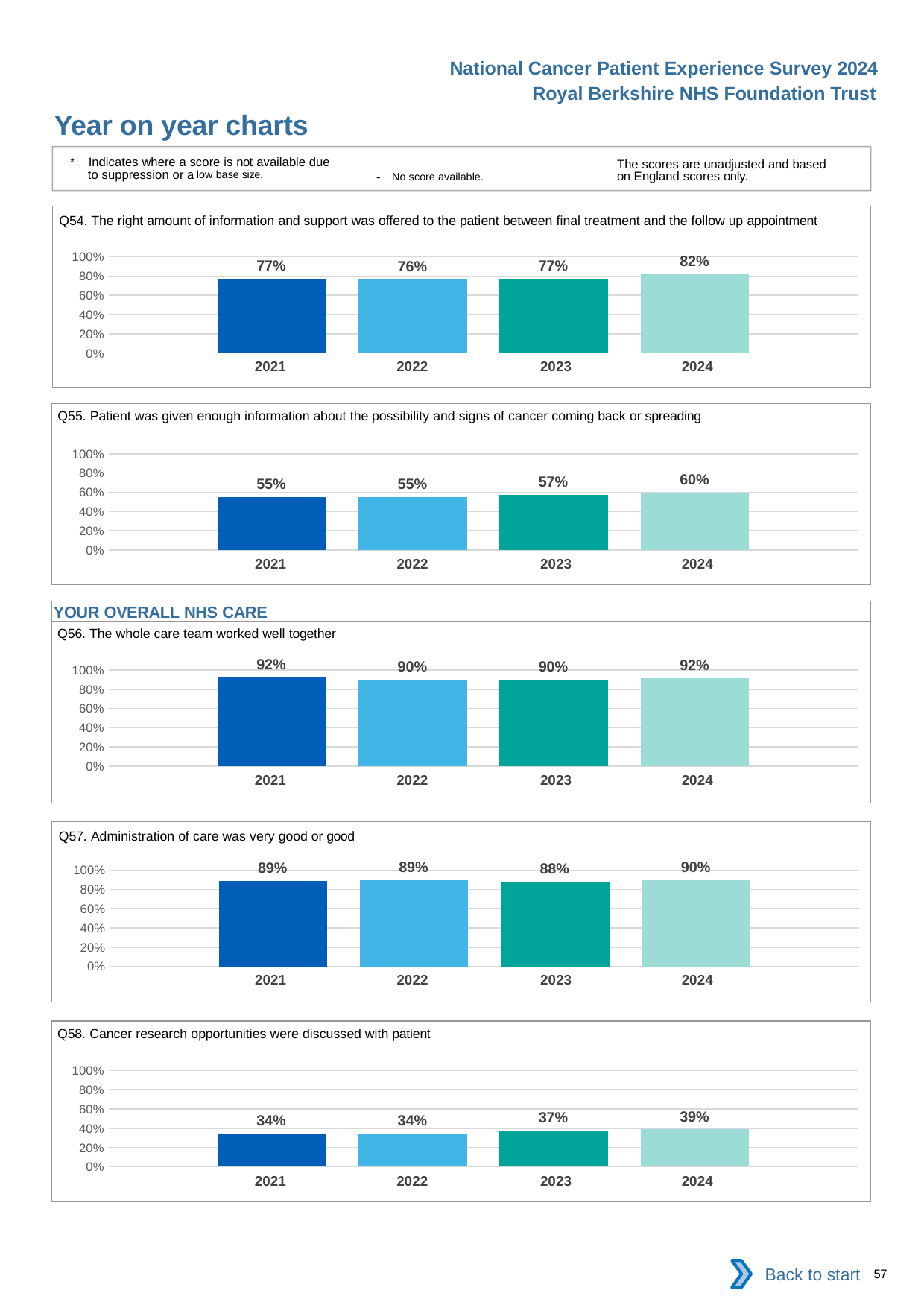
In the Q56 chart, what is the value for 2022? 90% In the Q55 chart, what is the value for 2023? 57% In the Q57 chart, what is the value for 2021? 89% In the Q58 chart, which is larger, the value for 2023 or the value for 2024? 2024 In the Q55 chart, what is the difference between the 2024 and 2021 values? 5 percentage points In the Q57 chart, which year has the lowest value? 2023 In the Q54 chart, which year has the highest value? 2024 What kind of chart is the Q58 chart? Bar chart In the Q58 chart, is the value for 2024 greater or less than 60%? less In the Q58 chart, what is the value for 2021? 34% In the Q56 chart, how many years are plotted? 4 In the Q54 chart, what is the value for 2024? 82%